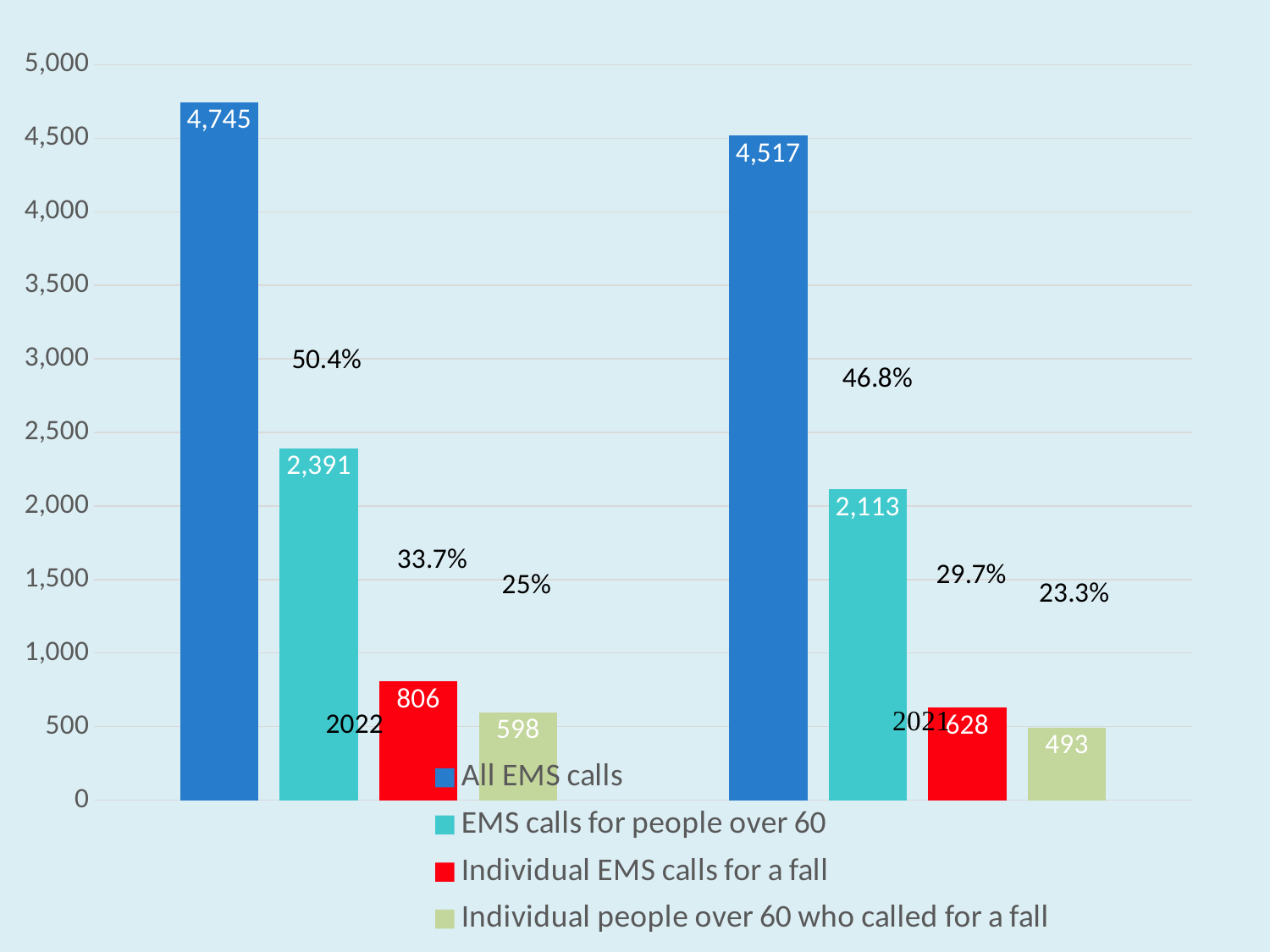
What is the value for EMS calls for people over 60 in 2021? 2,113 What is the value for Individual people over 60 who called for a fall in 2021? 493 What is the difference between All EMS calls in 2022 and in 2021? 228 How many year groups are shown on the x axis? 2 What is the difference between Individual EMS calls for a fall in 2022 and in 2021? 178 What is the value for Individual EMS calls for a fall in 2022? 806 What percentage label is shown next to the EMS calls for people over 60 bar for 2021? 46.8% Which series has the lowest value in 2022? Individual people over 60 who called for a fall What kind of chart is shown on the slide? bar chart Which year has the higher value for All EMS calls? 2022 How many series does the legend list? 4 What is the value for All EMS calls in 2022? 4,745